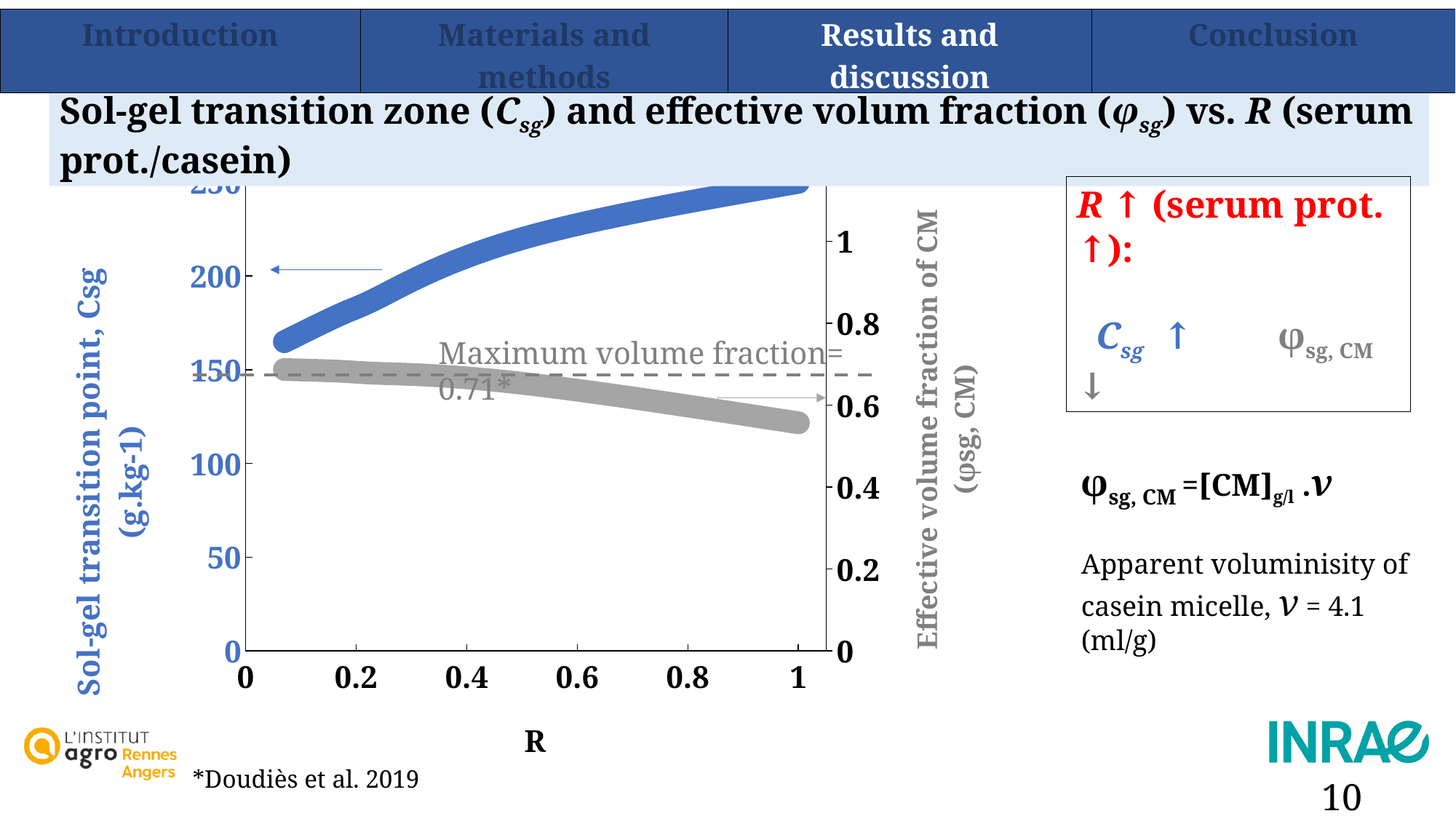
What value is the dashed horizontal line labelled as in the chart? Maximum volume fraction = 0.71* Is the blue curve (Csg) higher at R = 0.2 or at R = 1? R = 1 Is the value of the blue curve (Csg) at R = 0.2 greater or less than 200? less Is the grey curve (effective volume fraction) higher at R = 0.2 or at R = 1? R = 0.2 Does the grey curve (effective volume fraction of CM) rise or fall as R increases? fall Is the value of the blue curve (Csg) at R = 1 greater or less than 200? greater Is the value of the grey curve (effective volume fraction) at R = 0.2 greater or less than 0.6? greater Does the blue curve (sol-gel transition point, Csg) rise or fall as R increases? rise How many data series (curves) are plotted in the chart? 2 What kind of chart is shown on the slide? line chart What is the label of the x axis of the chart? R